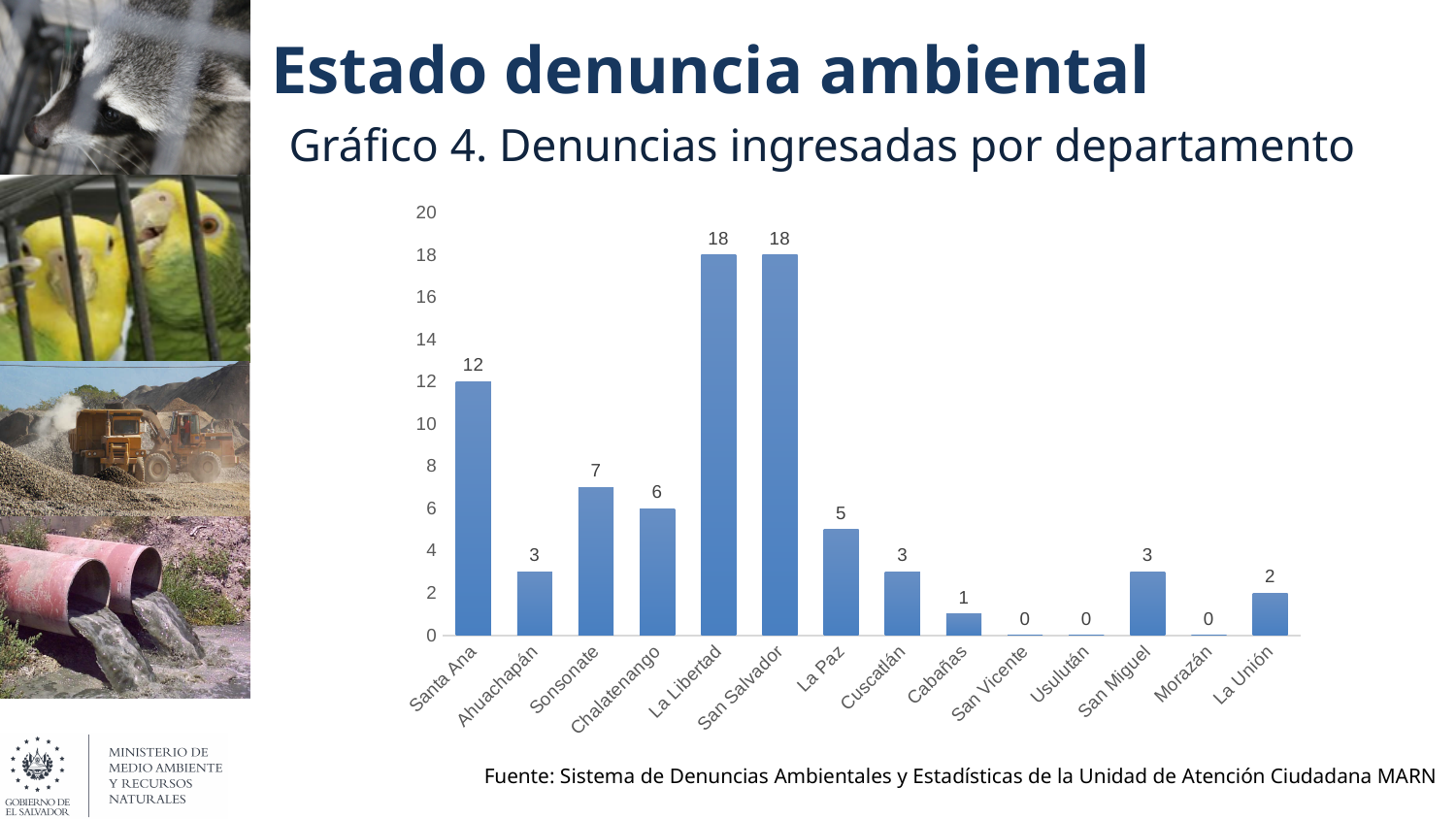
What is the value for Sonsonate? 7 What is the difference between the values for San Salvador and Santa Ana? 6 What is the value for La Libertad? 18 What is the title of the chart? Gráfico 4. Denuncias ingresadas por departamento What is the value for Santa Ana? 12 What is the highest value shown in the chart? 18 How many departments are shown on the x axis of the chart? 14 What is the value for Usulután? 0 Which has a larger value, Chalatenango or La Paz? Chalatenango What is the value for La Unión? 2 What is the difference between the values for Sonsonate and Cuscatlán? 4 What kind of chart is shown on the slide? bar chart